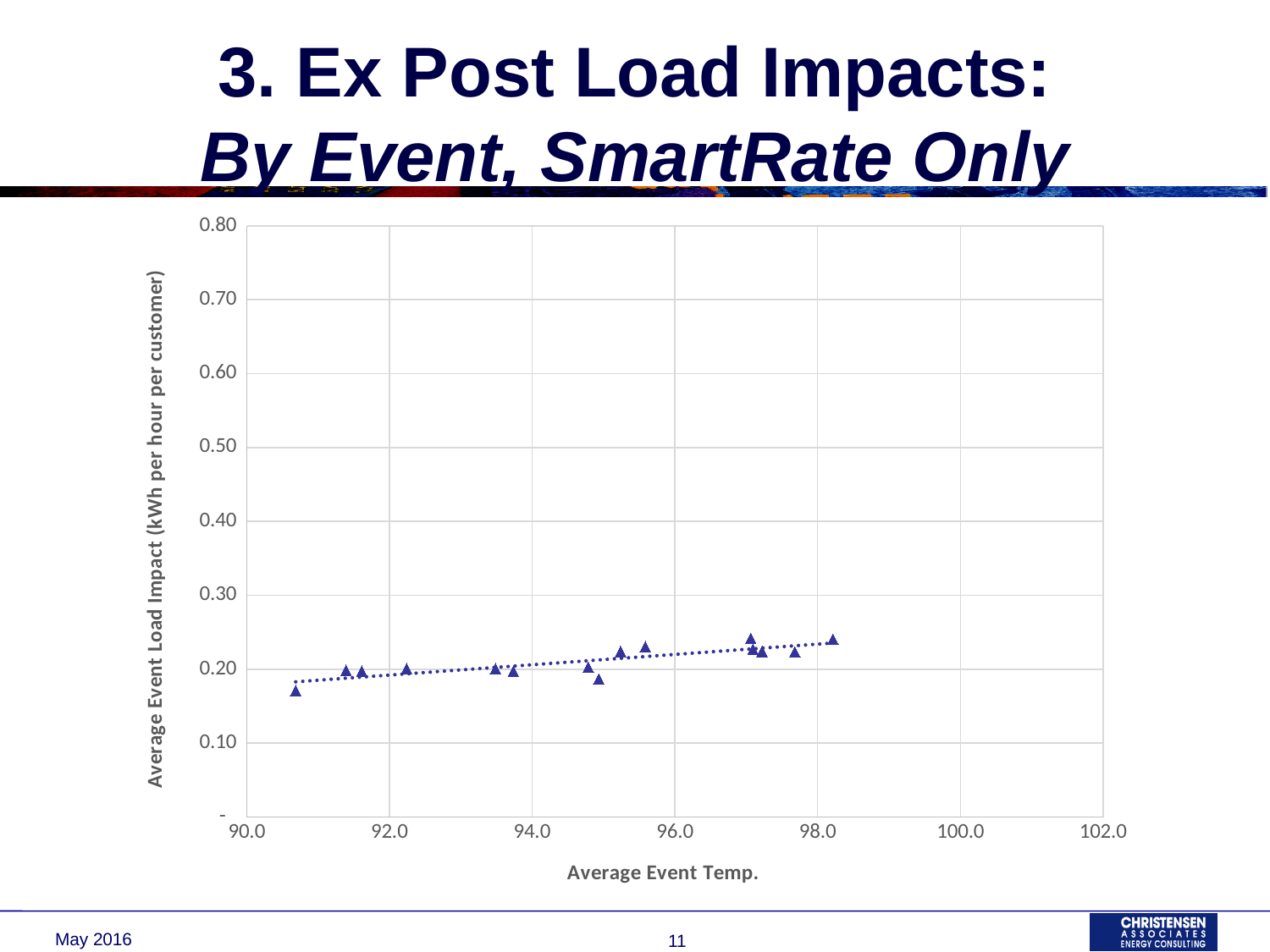
Is the load impact for the point near 95.6 degrees greater or less than 0.20? greater Is the load impact for the leftmost point (near 90.7 degrees) greater or less than 0.20? less What kind of chart is shown on the slide? scatter chart Are all of the plotted load impacts greater or less than 0.10? greater What is the highest value shown on the y axis? 0.80 Do the plotted load impacts generally rise or fall as average event temperature increases? rise What is the title of the x axis? Average Event Temp. What is the highest value shown on the x axis? 102.0 What is the title of the y axis? Average Event Load Impact (kWh per hour per customer)